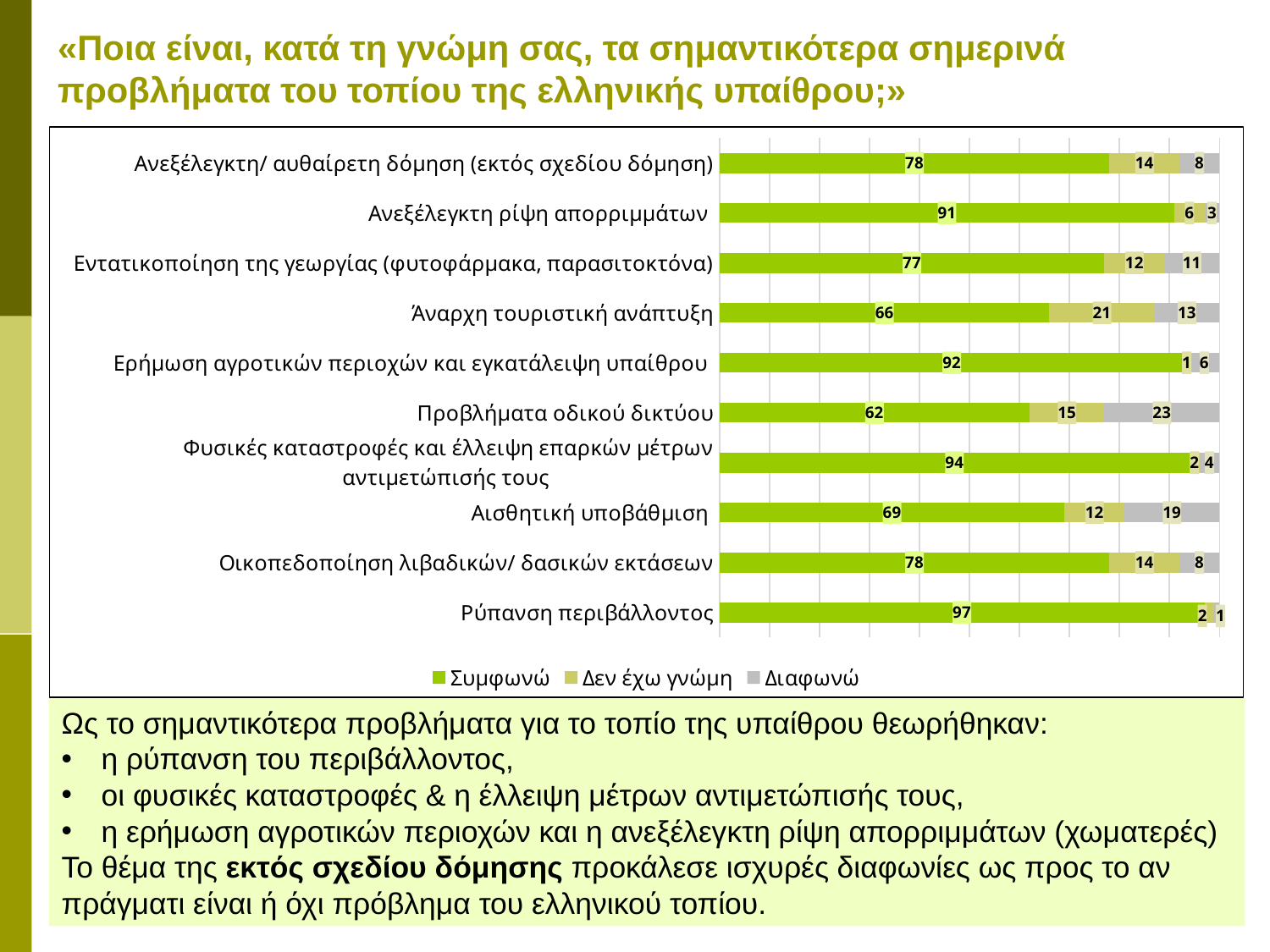
Which legend entry is shown in grey? Διαφωνώ What is the Διαφωνώ value for Προβλήματα οδικού δικτύου? 23 What is the difference between the Συμφωνώ values for Ανεξέλεγκτη ρίψη απορριμμάτων and Άναρχη τουριστική ανάπτυξη? 25 What is the total of the stacked bar for Ερήμωση αγροτικών περιοχών και εγκατάλειψη υπαίθρου? 99 Which category has the highest Συμφωνώ value? Ρύπανση περιβάλλοντος How many categories (problems) are plotted in the chart? 10 What is the Δεν έχω γνώμη value for Άναρχη τουριστική ανάπτυξη? 21 What is the Συμφωνώ value for Ρύπανση περιβάλλοντος? 97 How many series does the legend list? 3 Which category has the lowest Συμφωνώ value? Προβλήματα οδικού δικτύου What type of chart is shown on the slide? Stacked bar chart Which has a larger Διαφωνώ value: Αισθητική υποβάθμιση or Εντατικοποίηση της γεωργίας? Αισθητική υποβάθμιση